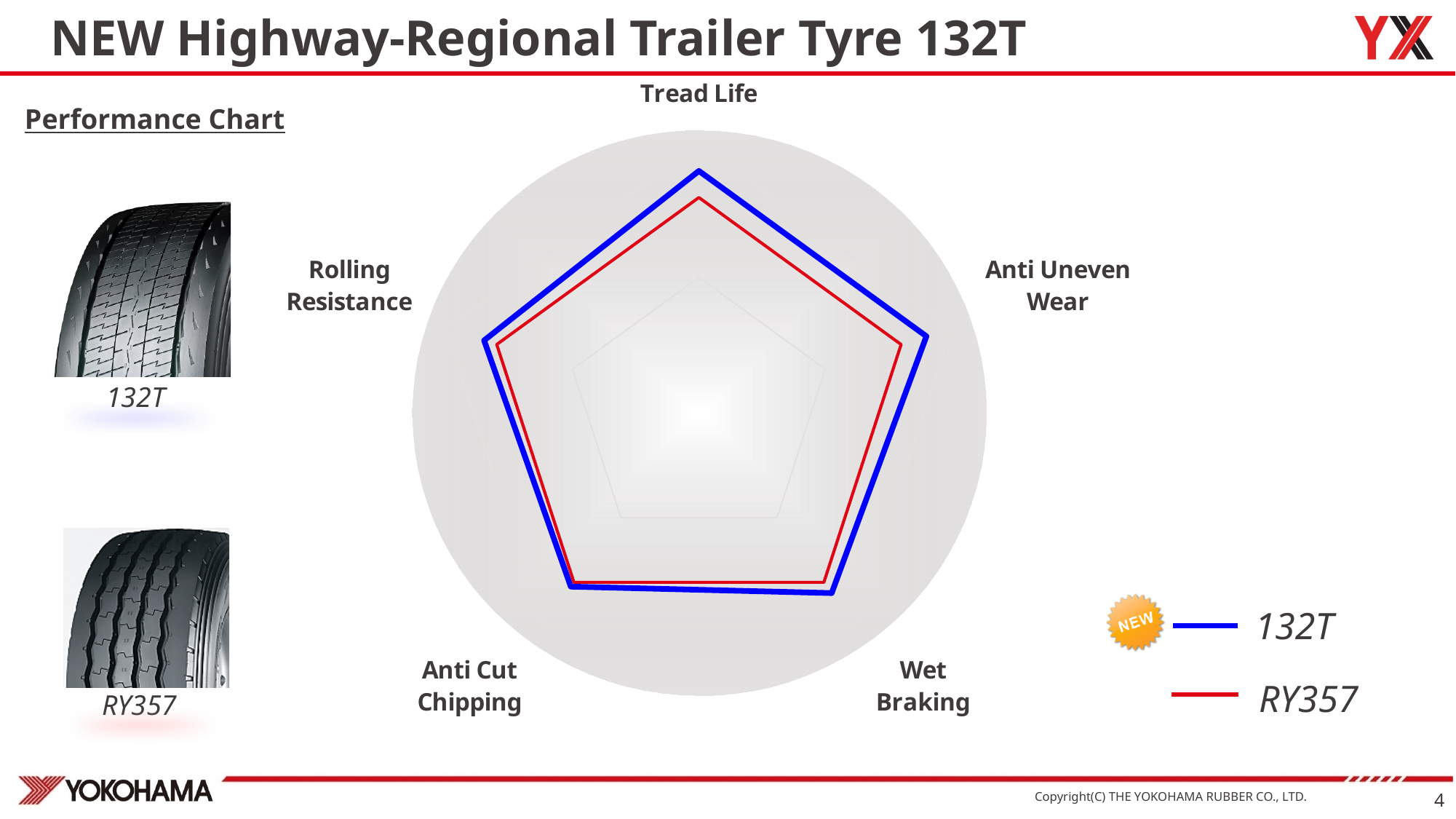
Which two tyres are compared in the Performance Chart? 132T and RY357 Which colour represents the 132T tyre in the Performance Chart? Blue How many series does the legend of the Performance Chart list? 2 Which tyre scores higher on Anti Uneven Wear, 132T or RY357? 132T Which category is at the top of the radar chart? Tread Life Which tyre scores higher on Tread Life, 132T or RY357? 132T Which tyre scores higher on Wet Braking, 132T or RY357? 132T How many performance categories (axes) does the radar chart have? 5 What kind of chart is the Performance Chart? Radar chart